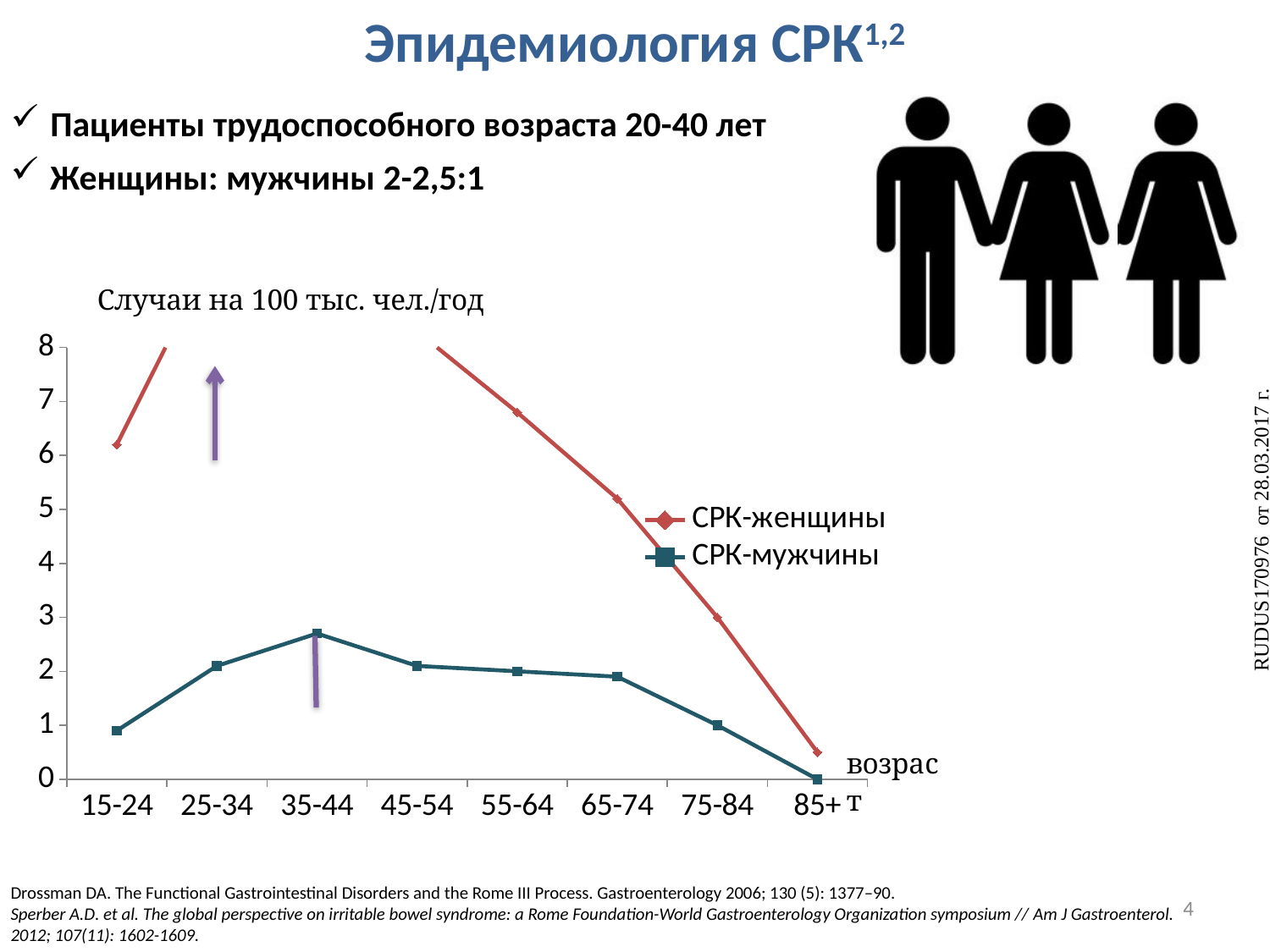
What is the label written above the y axis of the chart? Случаи на 100 тыс. чел./год Which age group has the lowest value for the СРК-мужчины series? 85+ How many age groups are shown on the x axis of the chart? 8 Which series has the larger value for the 15-24 age group, СРК-женщины or СРК-мужчины? СРК-женщины Is the value for СРК-мужчины in the 35-44 age group greater or less than 2? greater Is the value for СРК-женщины in the 15-24 age group greater or less than 5? greater Is the value for СРК-женщины in the 75-84 age group greater or less than 4? less Do the values for СРК-мужчины rise or fall from the 35-44 age group to the 85+ age group? fall Which age group has the highest value for the СРК-мужчины series? 35-44 How many series does the chart legend list? 2 What kind of chart is shown on the slide? line chart